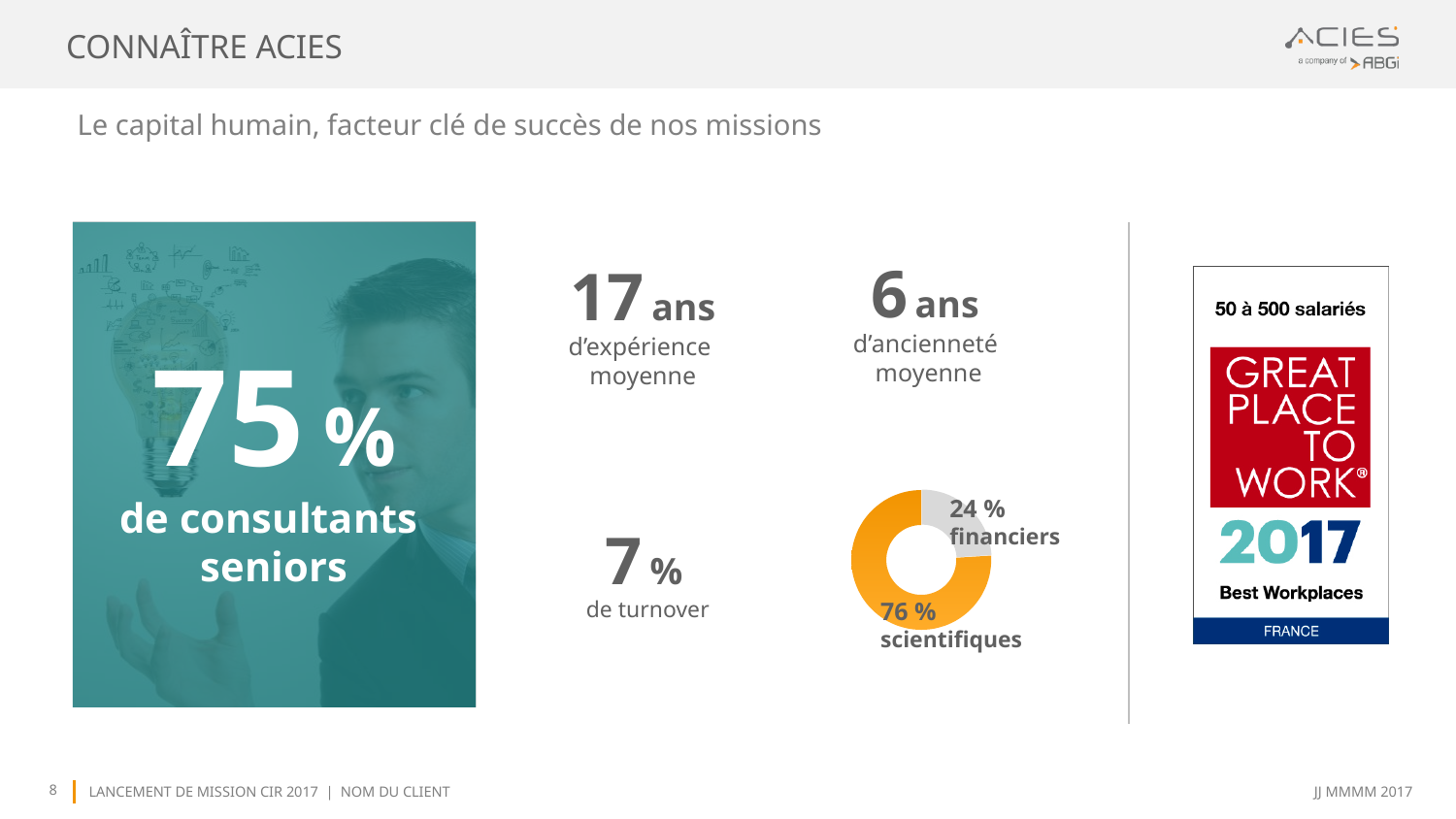
Is the share for financiers greater or less than 50 %? less What kind of chart is shown on the slide? Donut (pie) chart What colour is the scientifiques slice of the donut chart? Orange Which slice of the donut chart is the largest? scientifiques What share of the donut chart is labelled 'scientifiques'? 76 % Which is larger in the donut chart, scientifiques or financiers? scientifiques What share of the donut chart is labelled 'financiers'? 24 % Which slice of the donut chart is the smallest? financiers What colour is the financiers slice of the donut chart? Grey What do the two slices of the donut chart add up to? 100 % What is the difference in percentage points between the scientifiques and financiers slices? 52 % How many slices does the donut chart have? 2